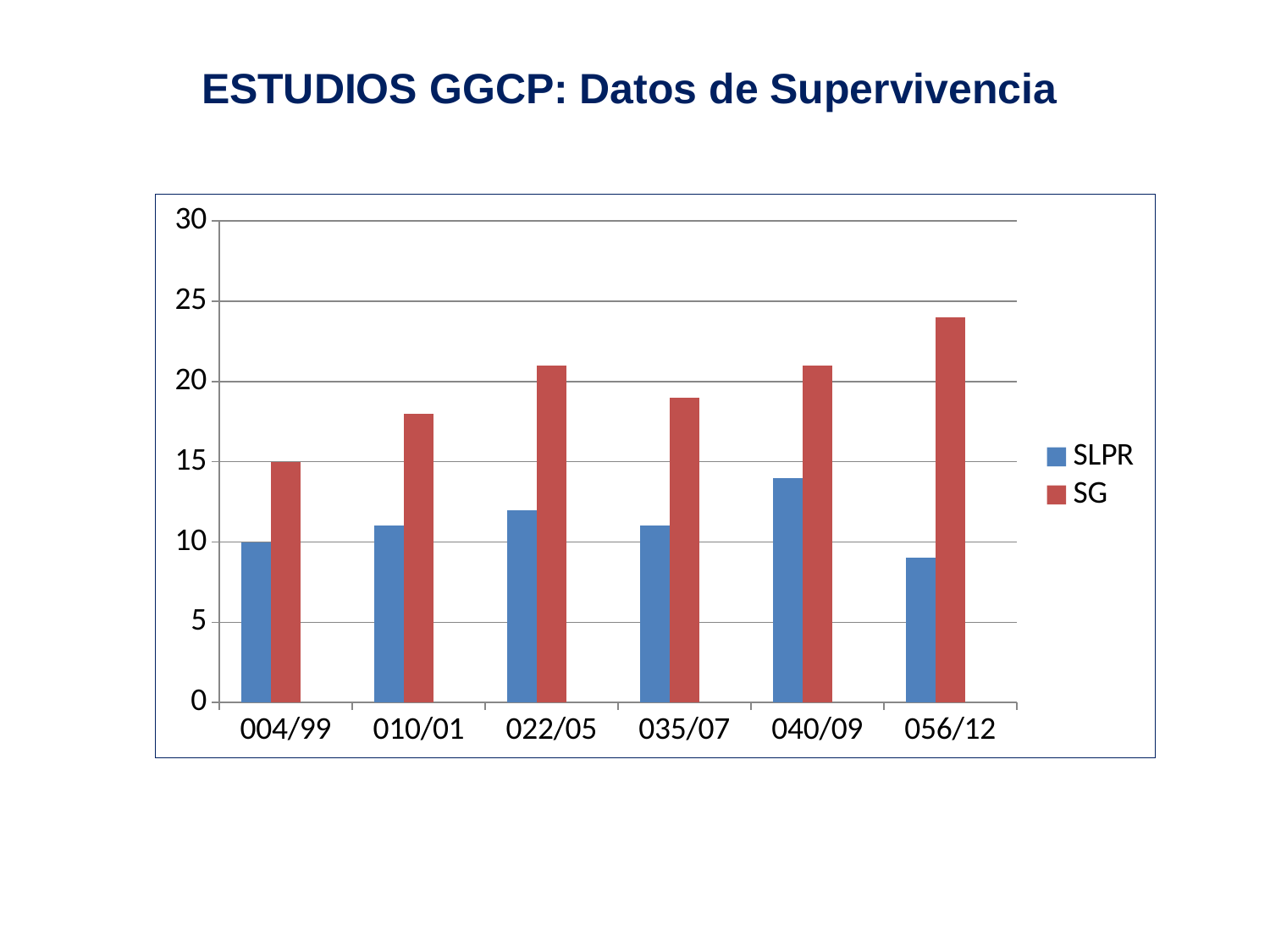
What is the SLPR value for 004/99? 10 Which category has the lowest SG value? 004/99 How many series does the legend list? 2 What is the SG value for 004/99? 15 Which category has the highest SLPR value? 040/09 For 022/05, which series has the larger value, SLPR or SG? SG How many categories are shown on the x axis? 6 Which category has the highest SG value? 056/12 Is the SG value for 056/12 greater or less than 20? greater Is the SG value for 010/01 greater or less than 20? less What type of chart is shown on the slide? bar chart Is the SLPR value for 056/12 greater or less than 10? less